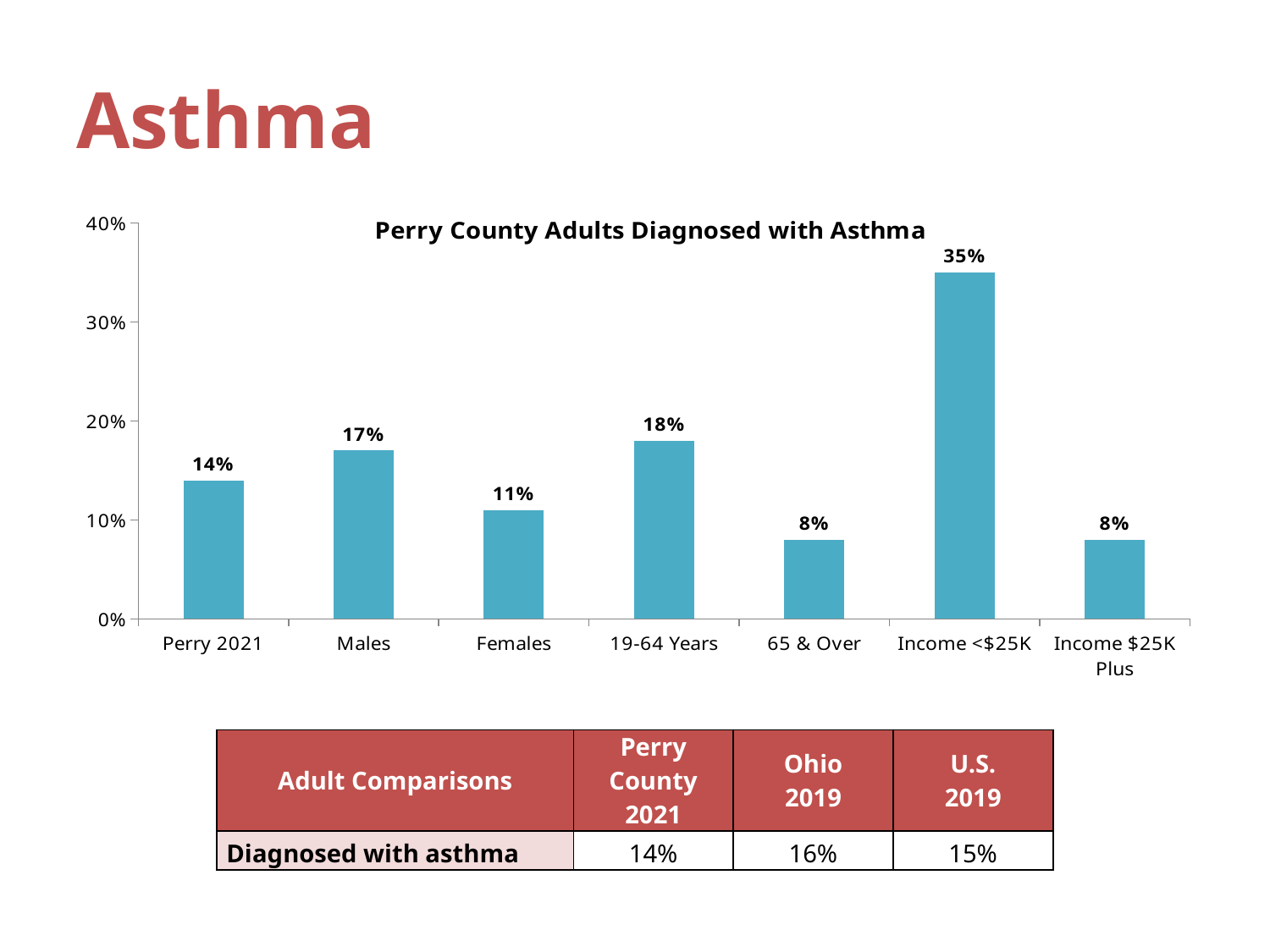
What is the difference between the values for Income <$25K and Income $25K Plus? 27% What is the value for Females in the chart? 11% What is the title of the chart? Perry County Adults Diagnosed with Asthma Is the value for Income <$25K greater or less than 30%? greater Which category has the highest value in the chart? Income <$25K What percentage of Perry County males were diagnosed with asthma? 17% What is the difference between the values for Males and Females? 6% What is the value for Perry 2021 in the chart? 14% How many categories are shown in the chart? 7 What is the value for Income <$25K in the chart? 35% Which is larger, the value for 19-64 Years or the value for 65 & Over? 19-64 Years What kind of chart is shown on the slide? Bar chart